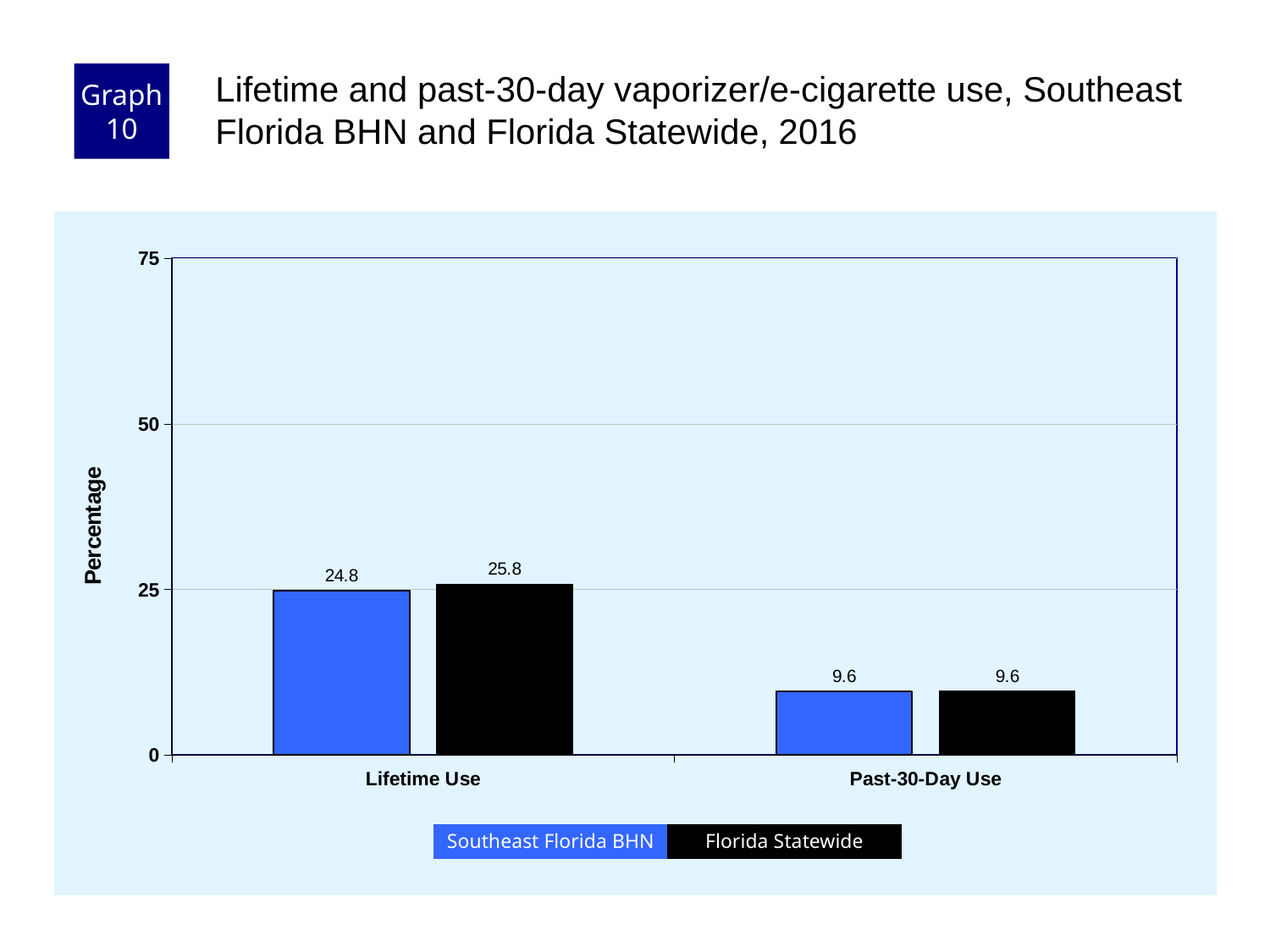
What is the Past-30-Day Use value for Southeast Florida BHN? 9.6 What is the label of the y axis? Percentage How many categories are shown on the x axis? 2 What is the Past-30-Day Use value for Florida Statewide? 9.6 How many series does the legend list? 2 Which category has the lower values, Lifetime Use or Past-30-Day Use? Past-30-Day Use What kind of chart is shown on the slide? bar chart What is the difference between the Florida Statewide and Southeast Florida BHN values for Lifetime Use? 1.0 What is the Lifetime Use value for Florida Statewide? 25.8 What is the Lifetime Use value for Southeast Florida BHN? 24.8 For Lifetime Use, which series has the higher value, Southeast Florida BHN or Florida Statewide? Florida Statewide Is the Lifetime Use value for Florida Statewide greater or less than 25? greater